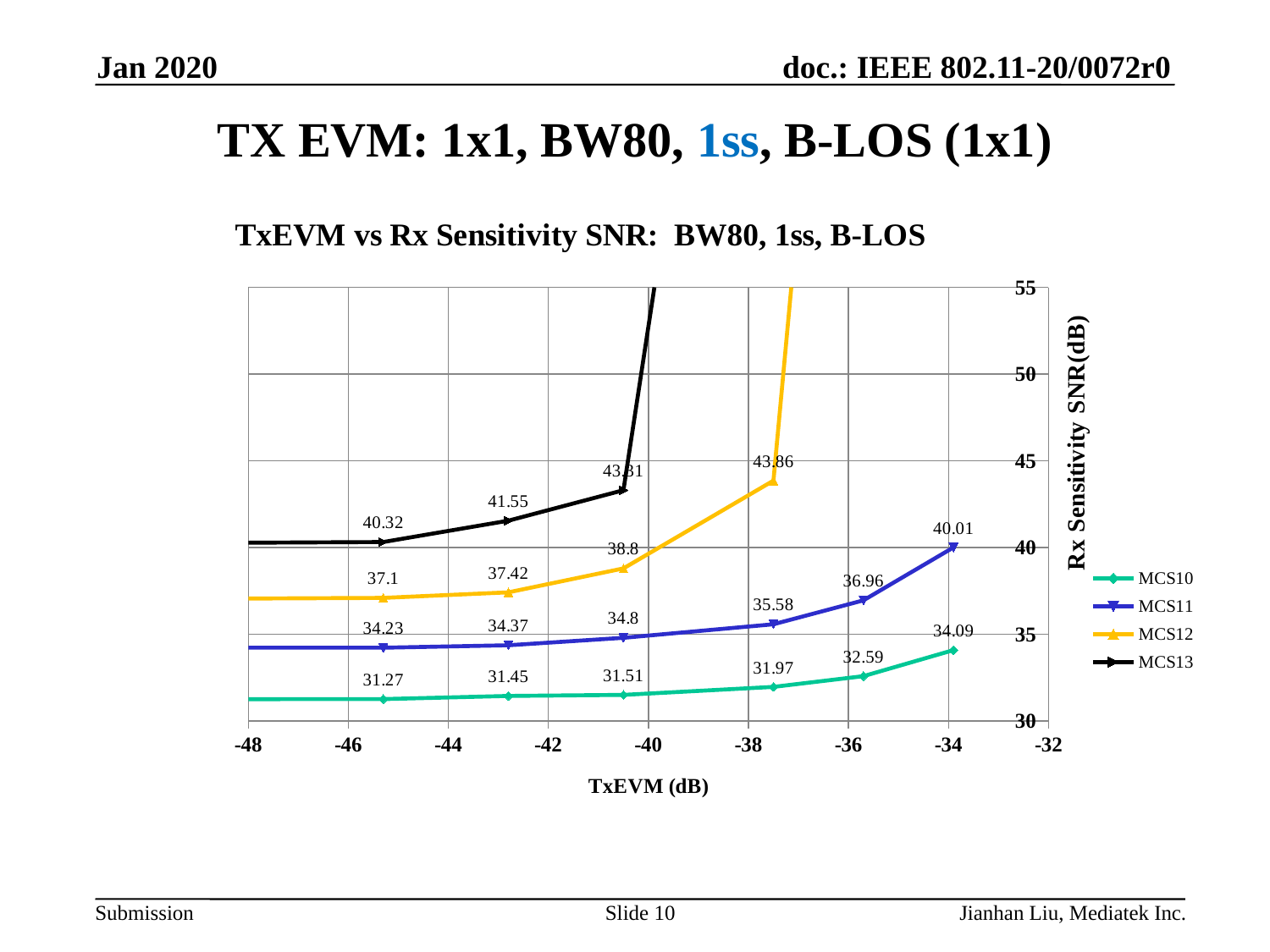
How many labeled data points are on the MCS10 line? 6 What is the lowest labeled value on the MCS10 line? 31.27 What kind of chart is shown on the slide? line chart What is the highest labeled value on the MCS12 line? 43.86 What is the title of the chart? TxEVM vs Rx Sensitivity SNR: BW80, 1ss, B-LOS What is the difference between the highest labeled value on the MCS11 line (40.01) and the highest labeled value on the MCS10 line (34.09)? 5.92 Does the MCS10 line rise or fall as TxEVM increases from -48 to -34 dB? rise What is the label on the x axis of the chart? TxEVM (dB) Which series has the highest Rx Sensitivity SNR values across the chart? MCS13 How many series does the legend list? 4 What is the highest labeled value on the MCS11 line? 40.01 What is the highest labeled value on the MCS10 line? 34.09